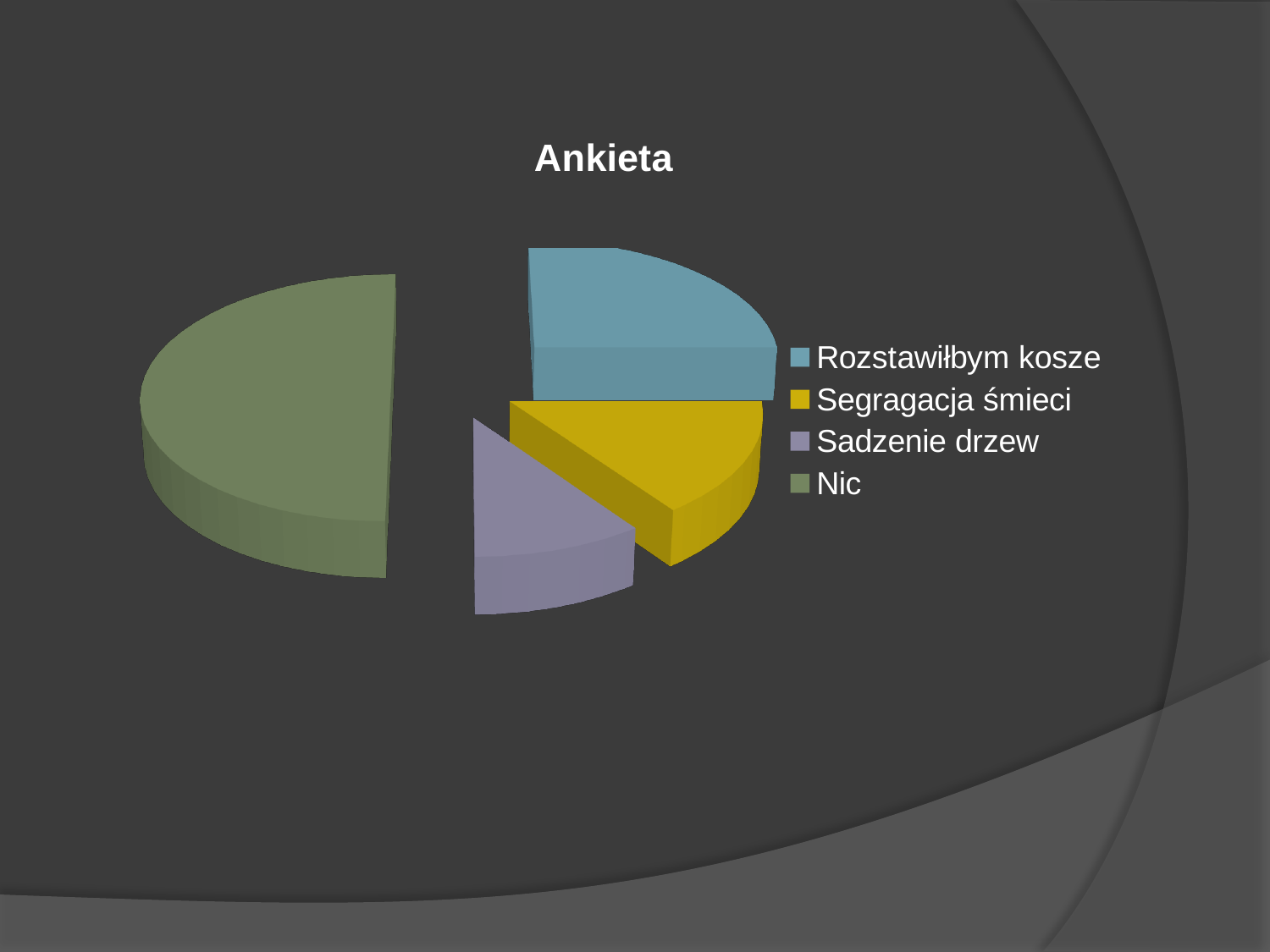
What kind of chart is shown on the slide? pie chart What is the title of the chart? Ankieta How many entries does the legend list? 4 Which category has the largest slice of the pie? Nic Which slice is larger, Nic or Segragacja śmieci? Nic What colour is the slice for Nic? green Which slice is larger, Nic or Sadzenie drzew? Nic Which category has the smallest slice of the pie? Sadzenie drzew Which slice is larger, Rozstawiłbym kosze or Sadzenie drzew? Rozstawiłbym kosze How many slices does the pie chart have? 4